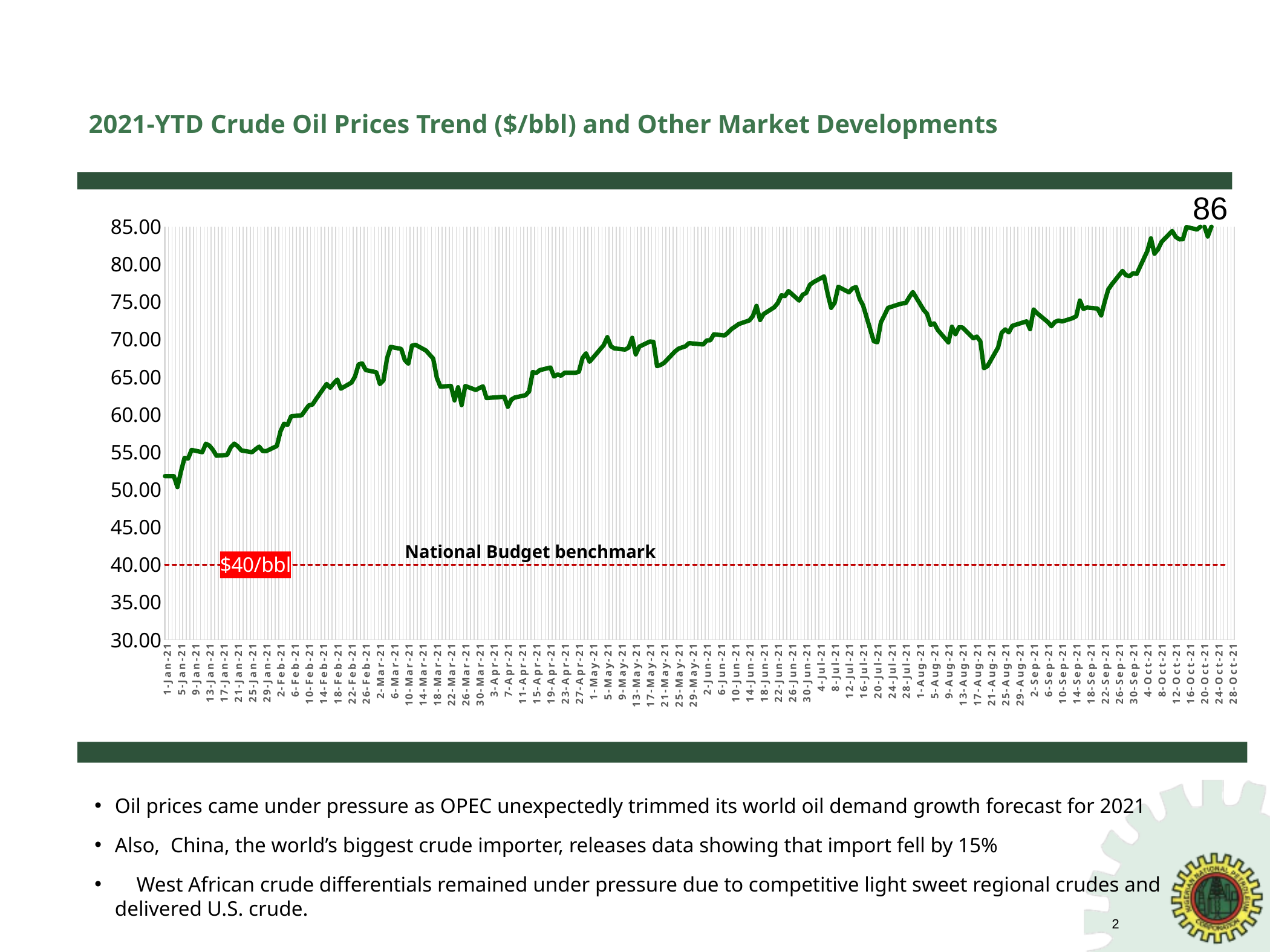
Is the value on 1-Jan-21 greater or less than 55.00? less Which is larger, the value around 4-Jul-21 or the value around 21-Aug-21? 4-Jul-21 Overall, do crude oil prices rise or fall from January 2021 to October 2021? rise What value is printed as a data label at the end of the line, near 20-Oct-21? 86 What is the title of the chart? 2021-YTD Crude Oil Prices Trend ($/bbl) and Other Market Developments Is the lowest point on the line greater or less than 45.00? greater What kind of chart is shown on the slide? line chart Is the value around 21-Aug-21 greater or less than 70.00? less What is the value of the National Budget benchmark shown by the dashed line? $40/bbl Which is larger, the value on 1-Jan-21 or the value on 20-Oct-21? 20-Oct-21